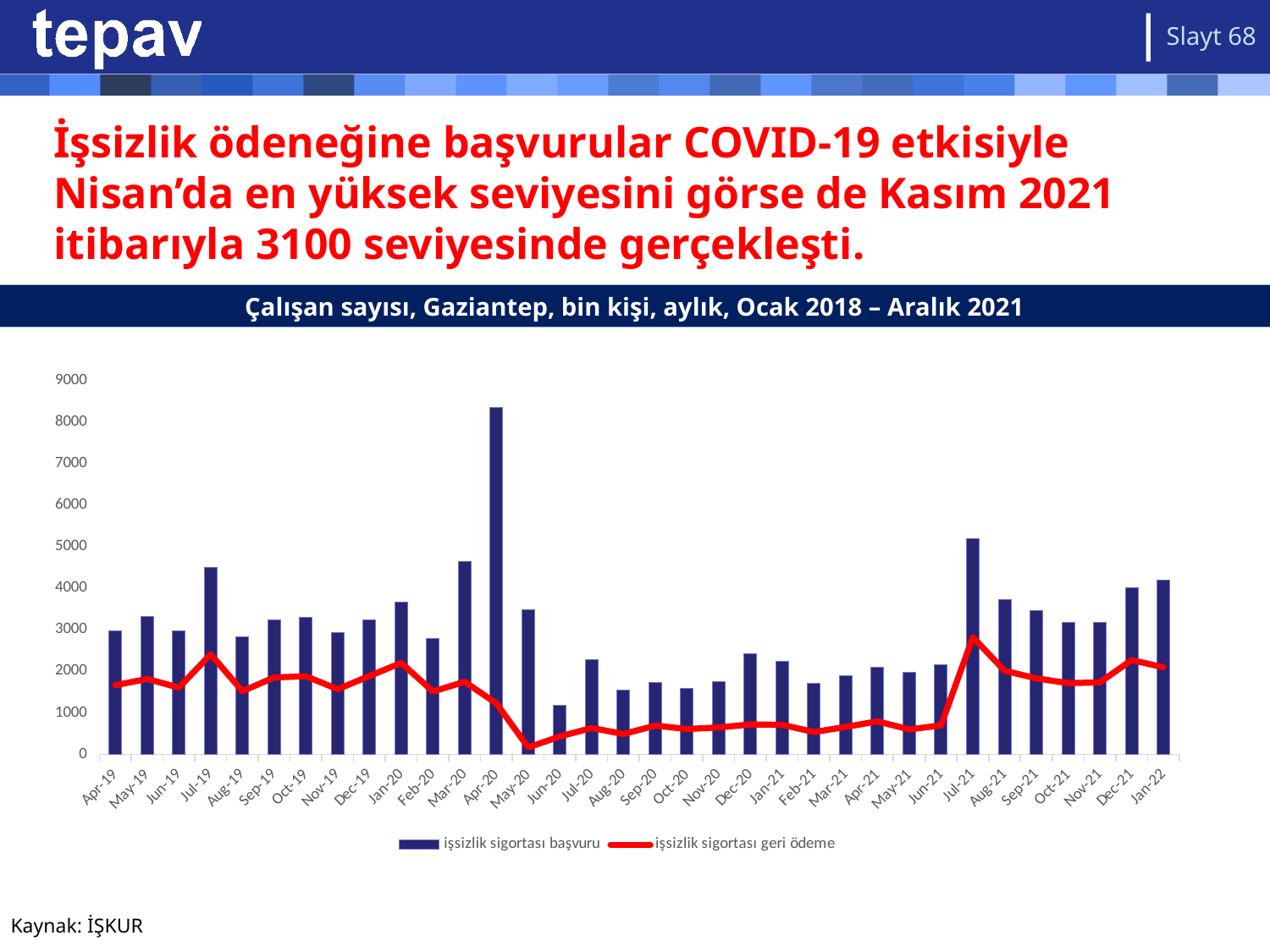
In which month is the bar for işsizlik sigortası başvuru highest? Apr-20 How many series does the legend list? 2 In which month does the red line for işsizlik sigortası geri ödeme reach its highest point? Jul-21 In which month is the bar for işsizlik sigortası başvuru lowest? Jun-20 What are the two series named in the legend? işsizlik sigortası başvuru and işsizlik sigortası geri ödeme Is the bar value for Apr-20 greater or less than 8000? greater What kind of chart is shown on the slide? A combined bar and line chart Which month has the larger bar, Apr-20 or Jul-21? Apr-20 Is the bar value for Jun-20 greater or less than 2000? less Is the red line value for May-20 greater or less than 1000? less How many months are shown on the x axis, from Apr-19 to Jan-22? 34 Does the red line rise or fall from Jul-21 to Nov-21? Fall